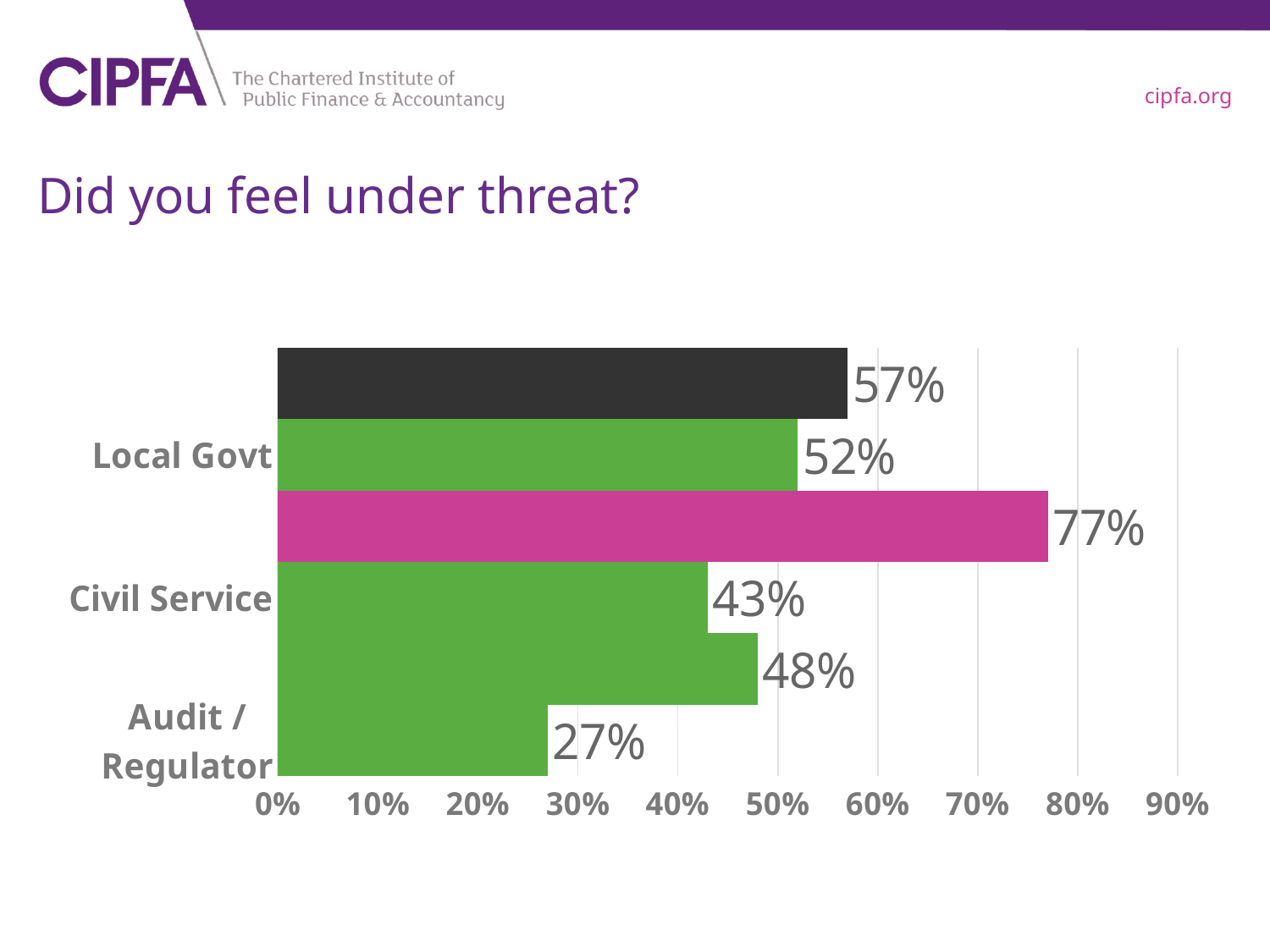
What is the difference between the bar labelled 48% and the bar labelled 27%? 21% What is the title of the slide containing the chart? Did you feel under threat? What is the lowest value shown by any bar in the chart? 27% Is the value of the topmost bar in the chart greater or less than 50%? greater Which is larger, the bar labelled 57% or the bar labelled 52%? 57% How many bars are plotted in the chart? 6 What is the highest value shown on the horizontal axis of the chart? 90% How many category labels are shown on the vertical axis of the chart? 3 Is the value of the bottom bar in the chart greater or less than 30%? less What is the highest value shown by any bar in the chart? 77% What type of chart is shown on the slide? bar chart What is the difference between the highest bar value (77%) and the lowest bar value (27%)? 50%